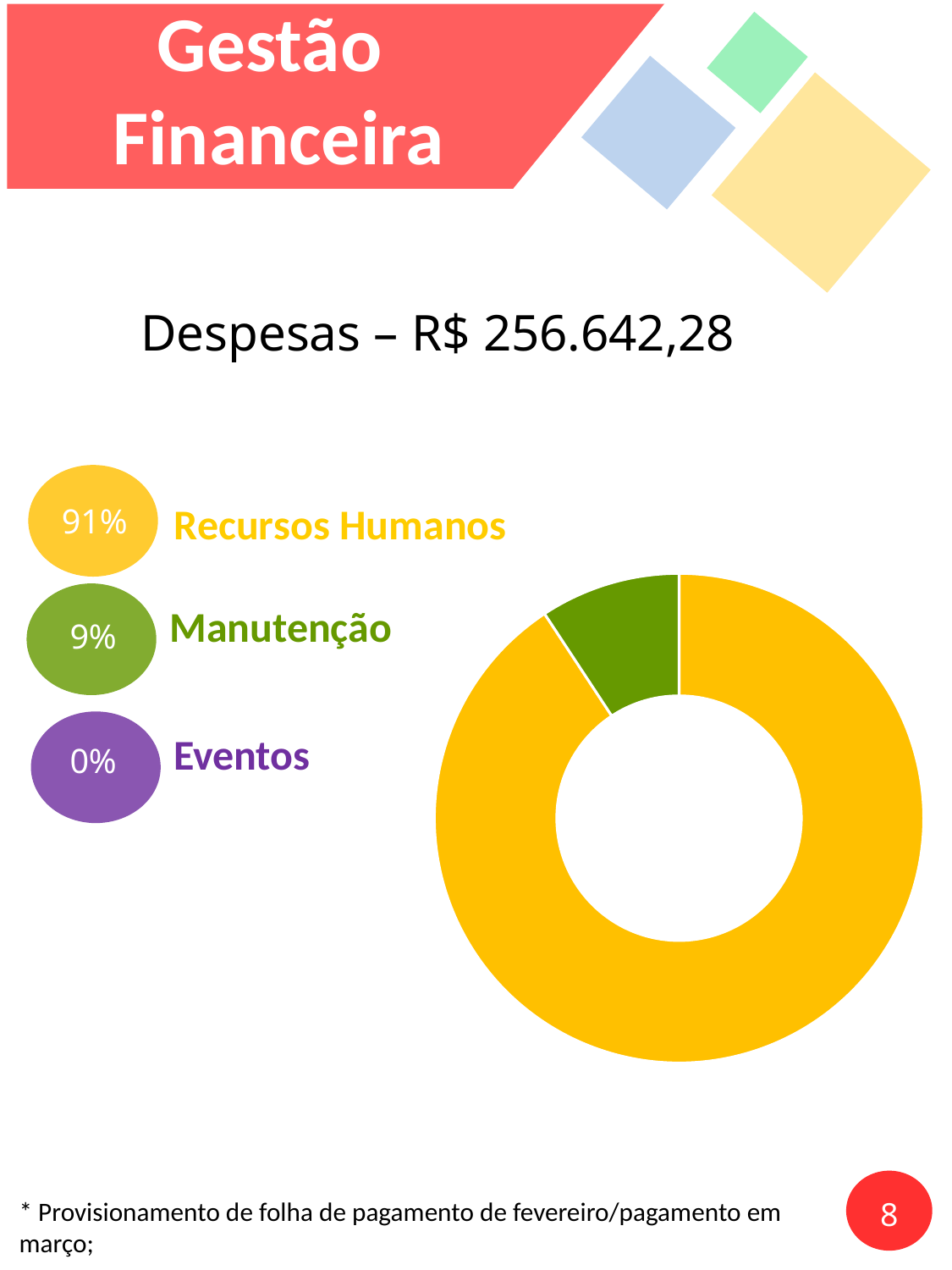
What kind of chart is shown on the slide? Doughnut chart What colour represents Manutenção in the chart? Green Which category has the smallest share of expenses? Eventos What share of expenses goes to Manutenção? 9% What share of expenses goes to Eventos? 0% What is the total amount of expenses (Despesas) stated on the slide? R$ 256.642,28 Which is larger, the share for Manutenção or the share for Eventos? Manutenção How many expense categories are shown in the chart? 3 What share of expenses goes to Recursos Humanos? 91% Which category has the largest share of expenses? Recursos Humanos What is the difference in percentage points between Recursos Humanos and Manutenção? 82